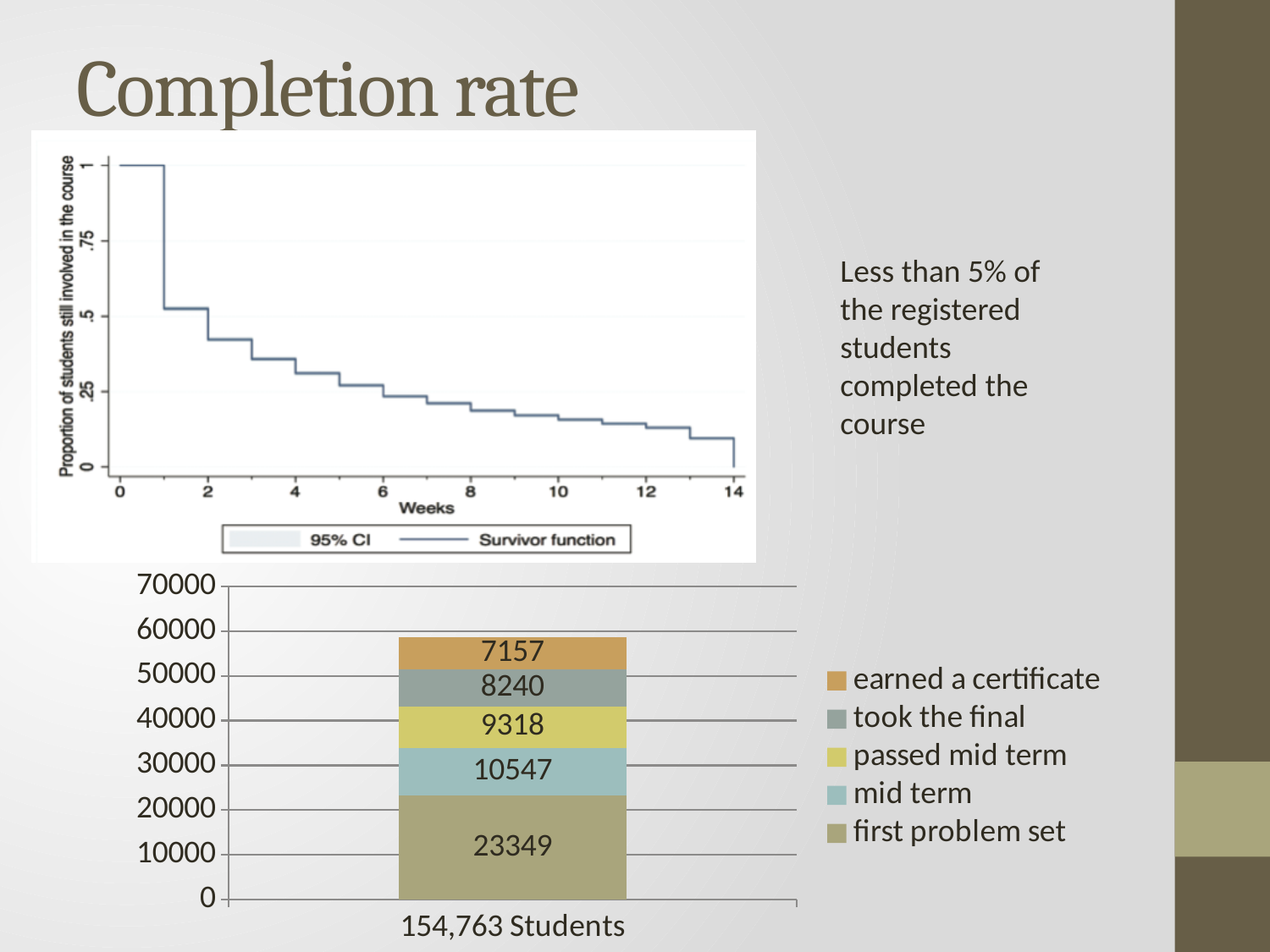
In the stacked bar chart at the bottom, what is the total of all segments in the bar? 58611 In the stacked bar chart at the bottom, which segment has the smallest value? earned a certificate What is the category label on the x axis of the stacked bar chart at the bottom? 154,763 Students In the stacked bar chart at the bottom, what is the value for 'earned a certificate'? 7157 In the stacked bar chart at the bottom, what is the value for 'first problem set'? 23349 How many series does the legend of the stacked bar chart at the bottom list? 5 In the stacked bar chart at the bottom, what is the difference between 'passed mid term' and 'took the final'? 1078 In the survivor function chart at the top, is the proportion of students still involved at week 10 greater or less than .25? less In the stacked bar chart at the bottom, which segment has the largest value? first problem set In the stacked bar chart at the bottom, which is larger: 'mid term' or 'passed mid term'? mid term In the stacked bar chart at the bottom, what is the value for 'mid term'? 10547 In the survivor function chart at the top, does the proportion of students still involved rise or fall as the weeks increase? fall